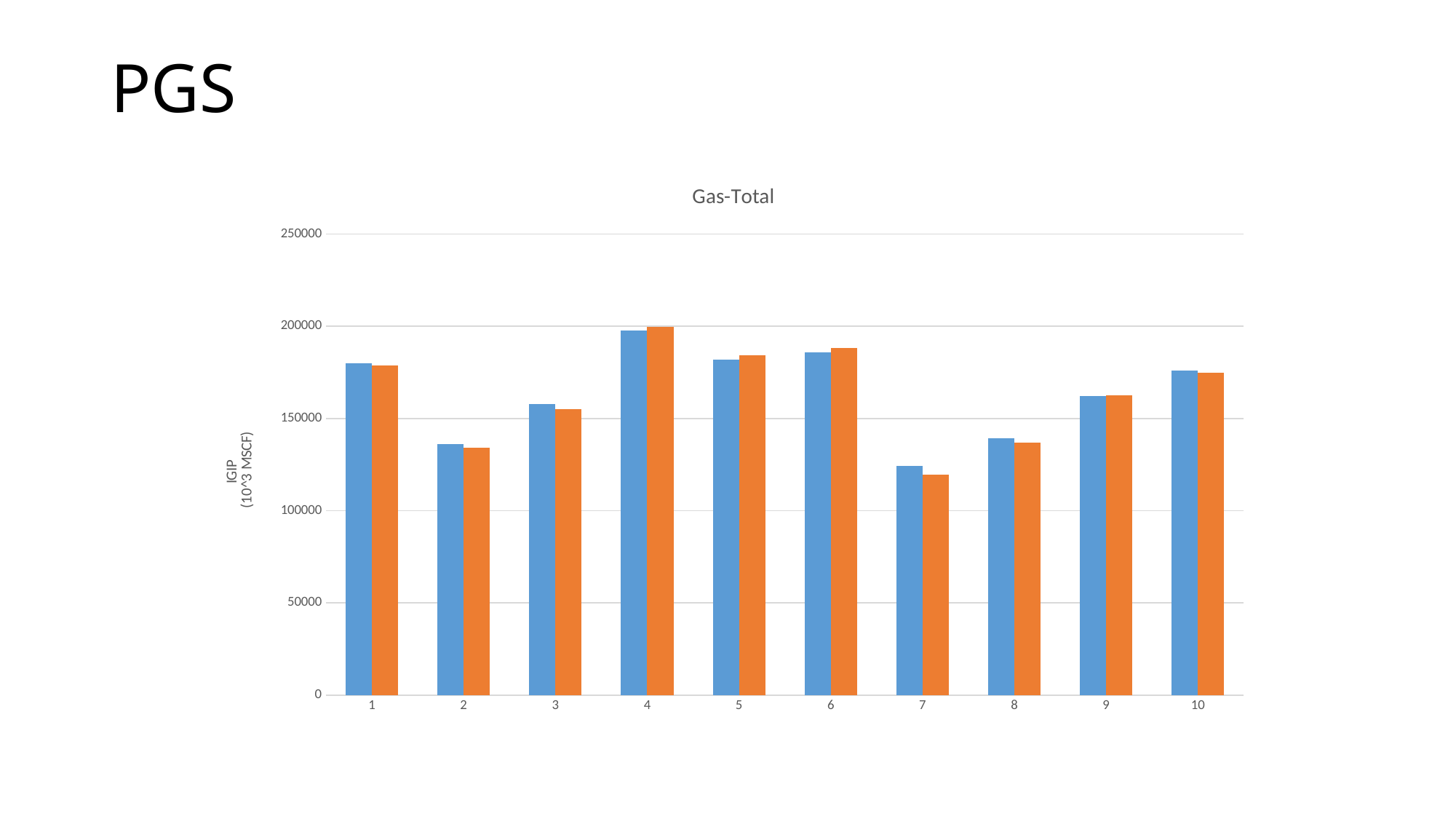
Which is larger, the blue bar for category 4 or the blue bar for category 7? category 4 Is the value of the blue bar for category 1 greater or less than 150000? greater Is the value of the orange bar for category 7 greater or less than 100000? greater Which category has the highest bars in the chart? 4 What is the title of the chart? Gas-Total Is the value of the blue bar for category 4 greater or less than 200000? less What kind of chart is shown on the slide? bar chart Which category has the lowest bars in the chart? 7 Which is larger, the orange bar for category 1 or the orange bar for category 2? category 1 What is the label on the vertical axis of the chart? IGIP (10^3 MSCF) How many categories are shown along the x axis of the chart? 10